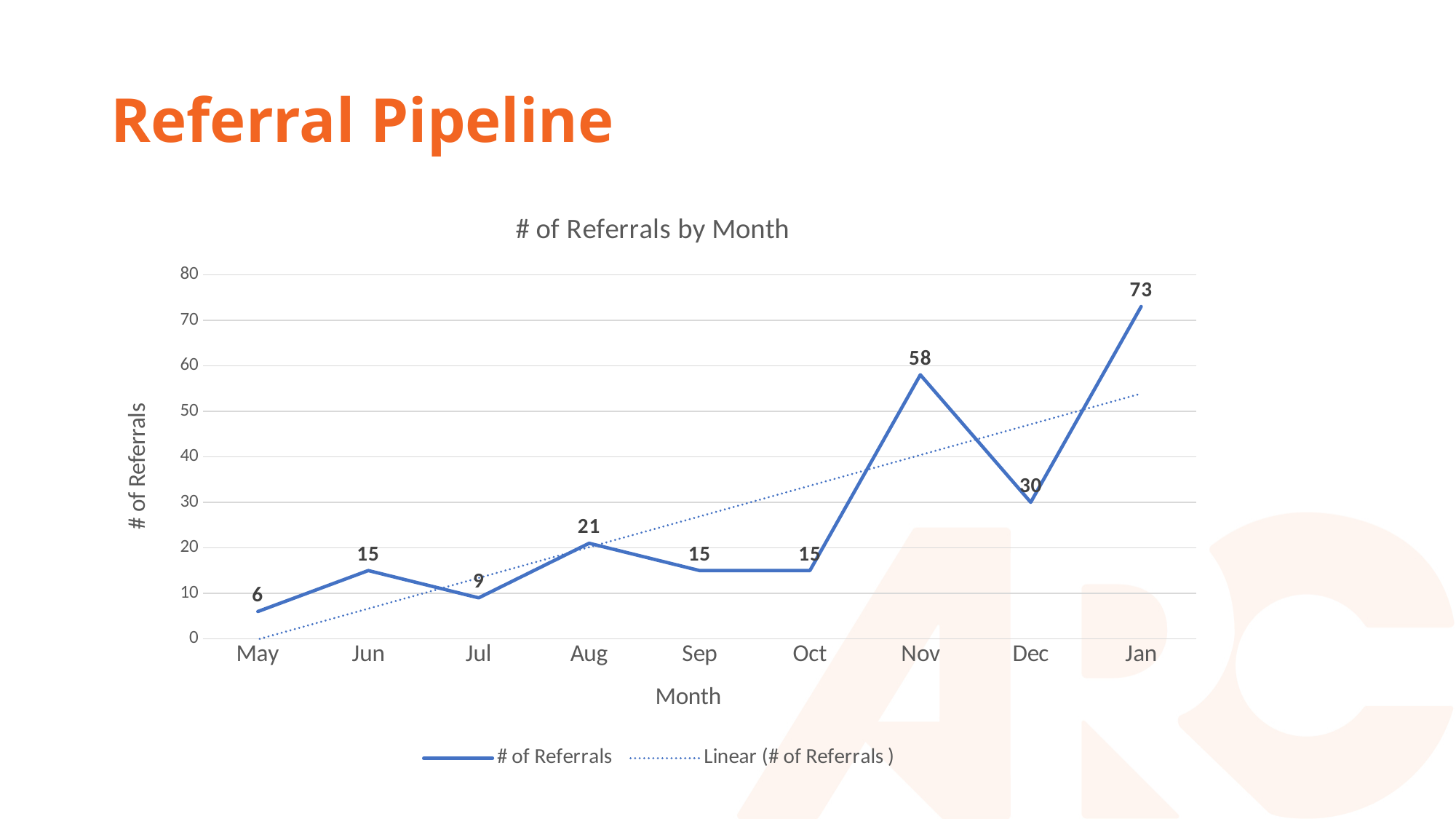
What is the difference in referrals between Aug and Jul? 12 What is the number of referrals in Dec? 30 What is the number of referrals in May? 6 What type of chart is shown on the slide? Line chart Which month has the highest number of referrals? Jan What is the difference in referrals between Jan and Nov? 15 Is the number of referrals in Dec greater or less than 40? less How many entries does the legend list? 2 How many months are plotted on the x axis? 9 Which month has more referrals, Jun or Aug? Aug What is the number of referrals in Nov? 58 Which month has the lowest number of referrals? May